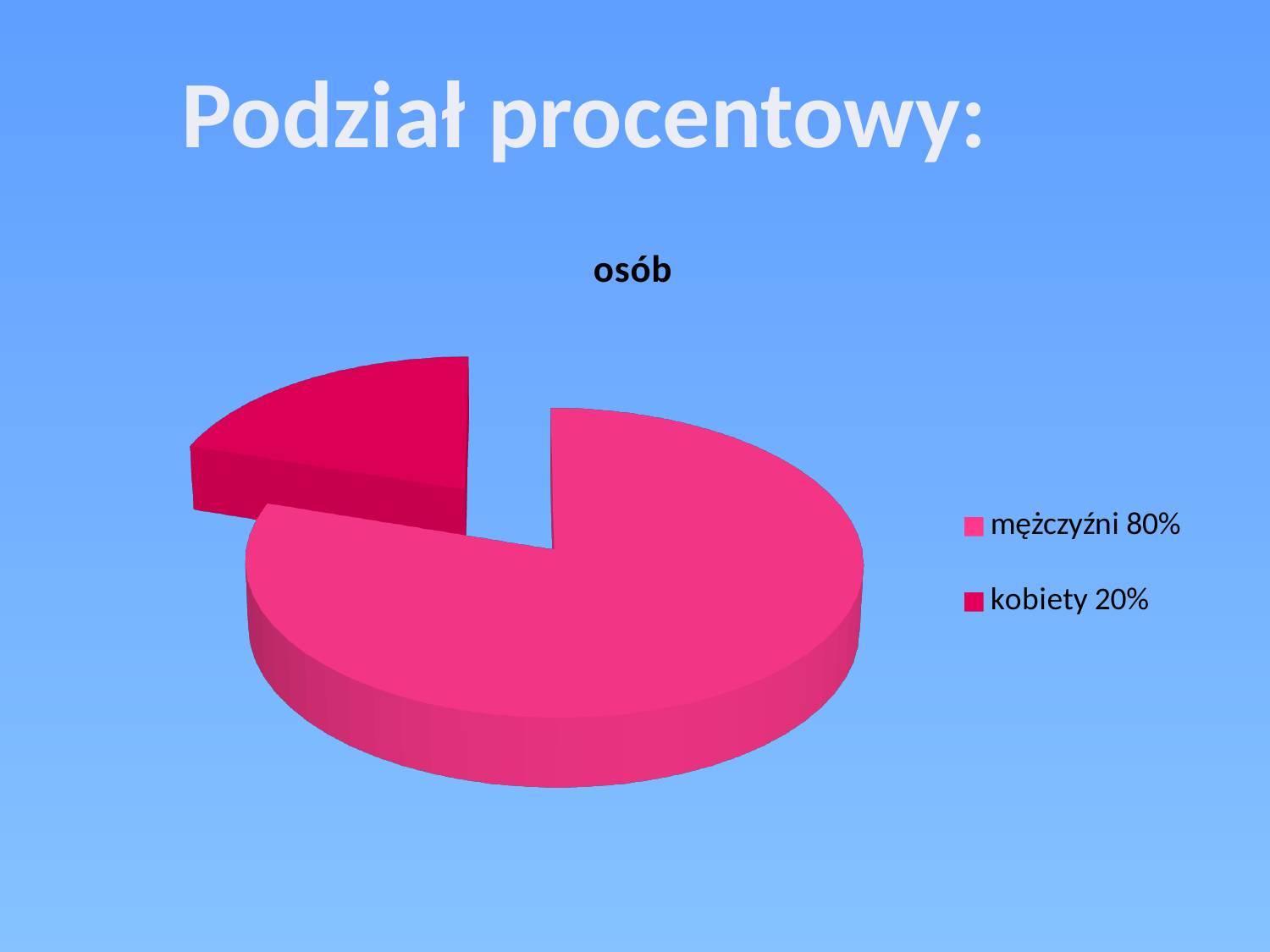
What is the title of the chart? osób Which is larger, the share for mężczyźni or the share for kobiety? mężczyźni Which category has the largest slice of the pie? mężczyźni What is the difference in percentage points between mężczyźni and kobiety? 60% How many entries does the legend list? 2 Which category has the smallest slice of the pie? kobiety What kind of chart is shown on the slide? pie chart Which slice is pulled out from the rest of the pie? kobiety How many categories does the pie chart show? 2 What share of the pie does kobiety represent? 20% What share of the pie does mężczyźni represent? 80%